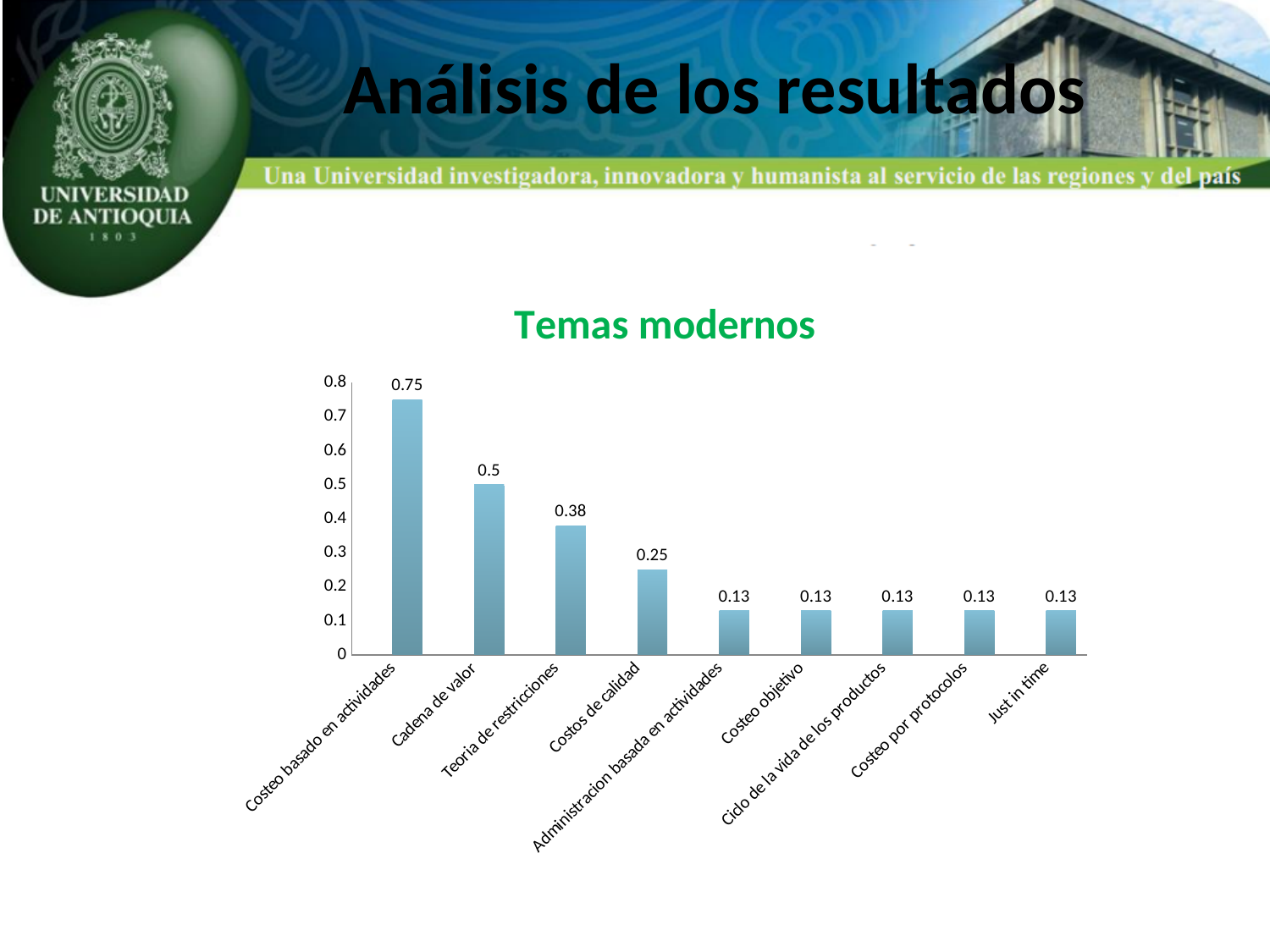
What is the value for Just in time? 0.13 What is the value for Teoria de restricciones? 0.38 What kind of chart is shown on the slide? Bar chart Which is larger, the value for Cadena de valor or the value for Costos de calidad? Cadena de valor What is the value for Costeo basado en actividades? 0.75 What is the title of the chart? Temas modernos How many categories are shown on the x axis? 9 What is the value for Cadena de valor? 0.5 What is the value for Costos de calidad? 0.25 What is the difference between the values for Costeo basado en actividades and Cadena de valor? 0.25 Which category has the highest value? Costeo basado en actividades What is the difference between the values for Teoria de restricciones and Costos de calidad? 0.13